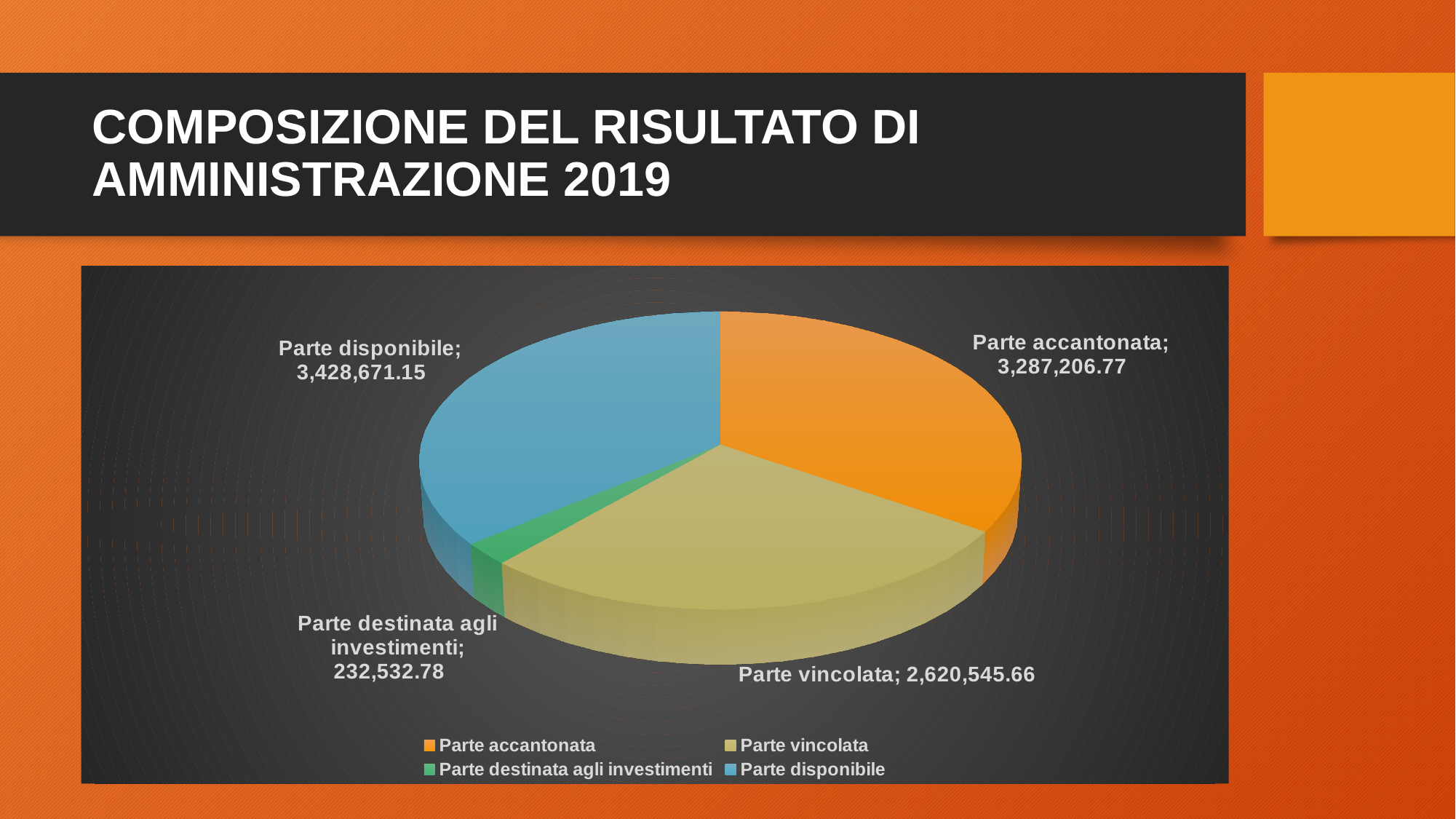
What is the value for Parte destinata agli investimenti? 232,532.78 Which category has the smallest value? Parte destinata agli investimenti What is the value for Parte accantonata? 3,287,206.77 What colour is the Parte disponibile slice? Blue What kind of chart is shown on the slide? Pie chart Which category has the largest value? Parte disponibile How many slices does the pie chart have? 4 What is the value for Parte disponibile? 3,428,671.15 Which is larger, Parte vincolata or Parte accantonata? Parte accantonata What is the value for Parte vincolata? 2,620,545.66 What is the difference between Parte accantonata and Parte vincolata? 666,661.11 What is the difference between Parte disponibile and Parte accantonata? 141,464.38